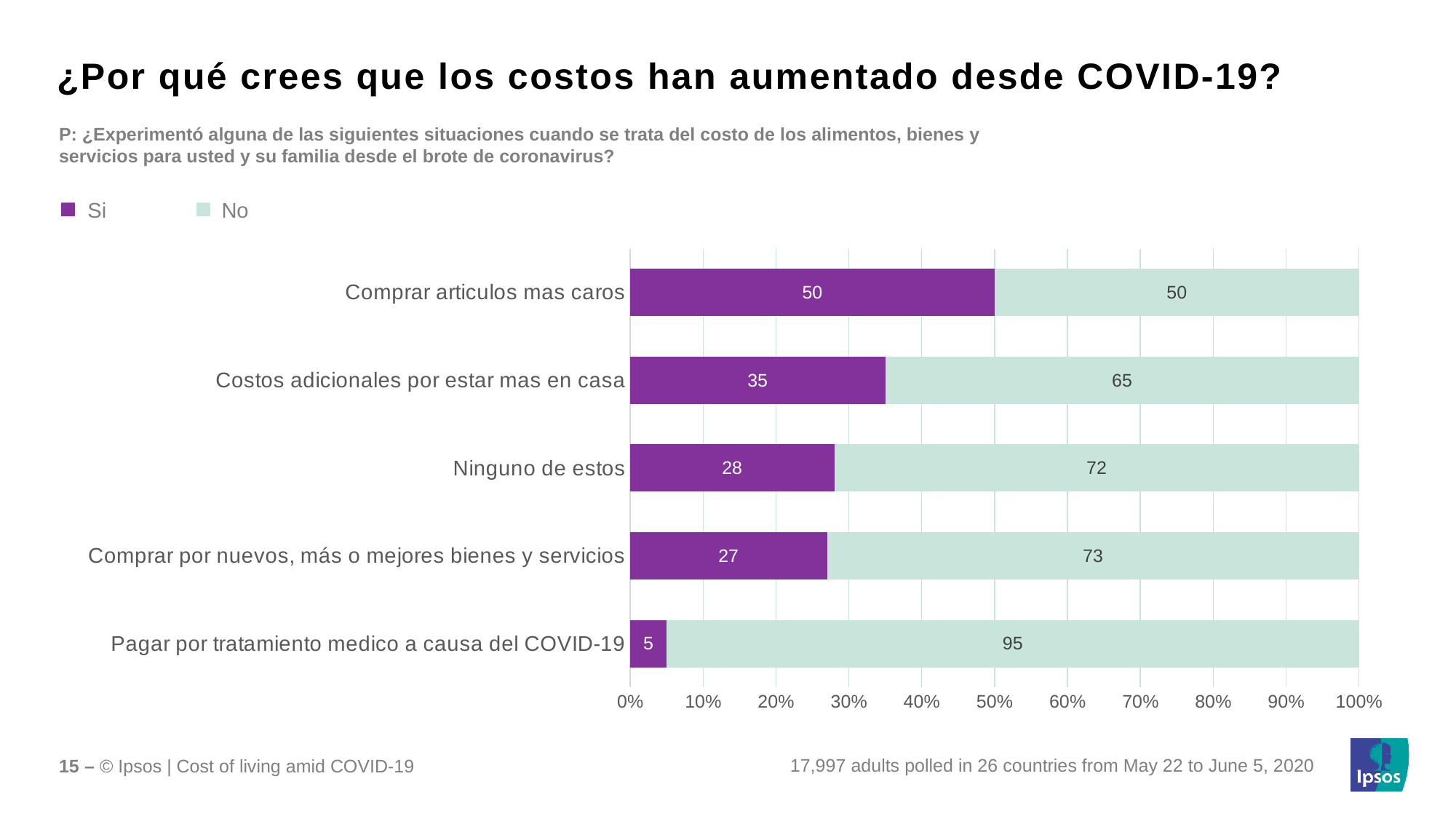
What is the "Si" value for "Comprar articulos mas caros"? 50 How many series does the legend list? 2 How many categories are shown in the chart? 5 Which is larger: the "Si" value for "Ninguno de estos" or the "Si" value for "Pagar por tratamiento medico a causa del COVID-19"? Ninguno de estos What is the "No" value for "Ninguno de estos"? 72 Which category has the lowest "Si" value? Pagar por tratamiento medico a causa del COVID-19 What is the "No" value for "Costos adicionales por estar mas en casa"? 65 What is the "Si" value for "Pagar por tratamiento medico a causa del COVID-19"? 5 Which category has the highest "Si" value? Comprar articulos mas caros What kind of chart is shown on the slide? Stacked bar chart What is the total of the stacked bar for "Comprar por nuevos, más o mejores bienes y servicios"? 100 What is the difference between the "Si" values for "Comprar articulos mas caros" and "Costos adicionales por estar mas en casa"? 15